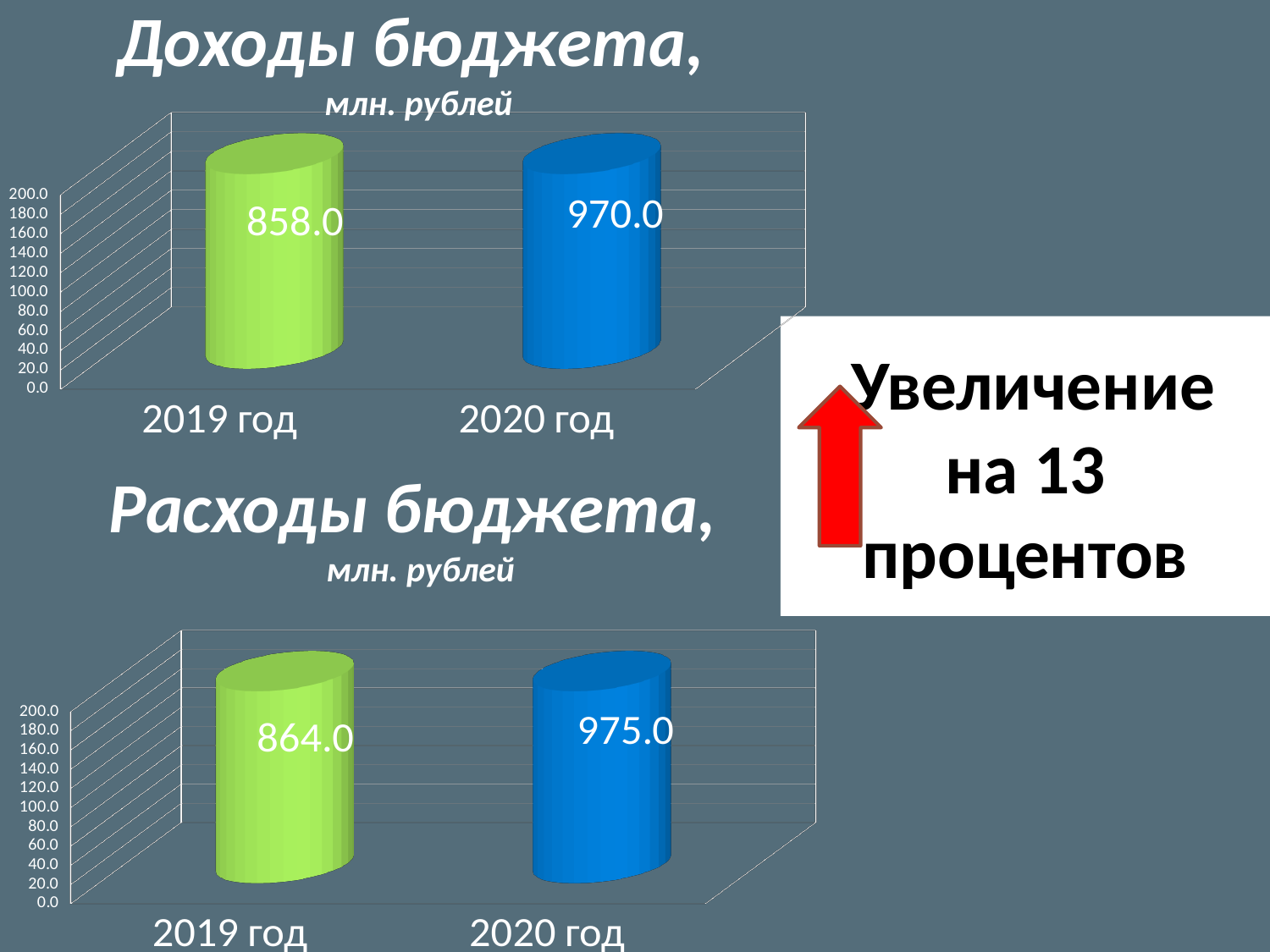
In the chart titled "Расходы бюджета", what is the value for 2020 год? 975.0 In the chart titled "Доходы бюджета", what is the difference between the 2020 год and 2019 год values? 112.0 What kind of chart is the chart titled "Расходы бюджета"? bar chart In the chart titled "Доходы бюджета", what is the value for 2020 год? 970.0 In the chart titled "Расходы бюджета", which year has the lower value? 2019 год In the chart titled "Доходы бюджета", which year has the higher value? 2020 год How many categories are shown in the chart titled "Доходы бюджета"? 2 In the chart titled "Расходы бюджета", what is the value for 2019 год? 864.0 In the chart titled "Расходы бюджета", is the value for 2020 год larger or smaller than the value for 2019 год? larger In the chart titled "Доходы бюджета", what is the value for 2019 год? 858.0 In the chart titled "Доходы бюджета", do the values rise or fall from 2019 год to 2020 год? rise In the chart titled "Расходы бюджета", what is the difference between the 2020 год and 2019 год values? 111.0